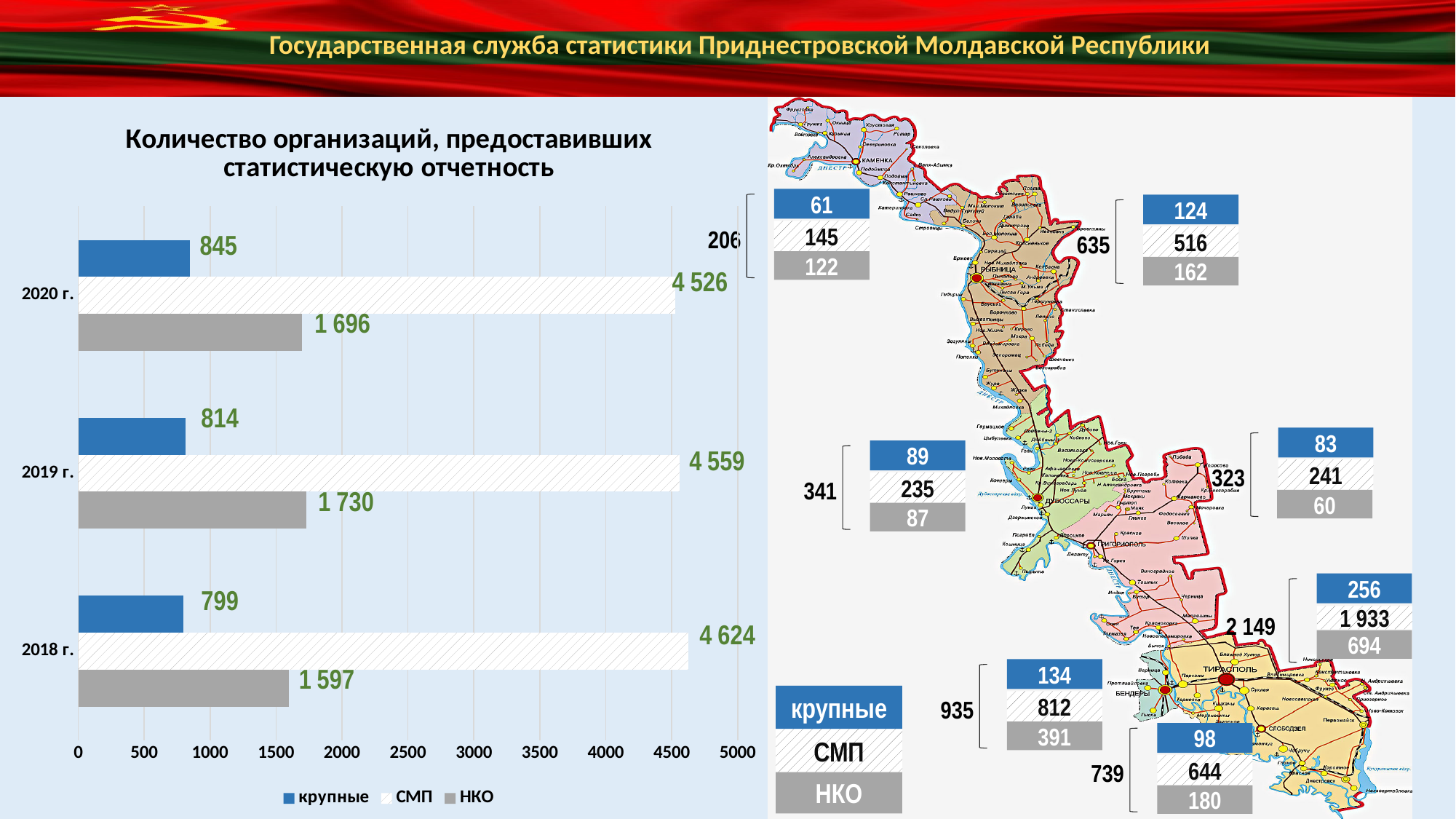
On the bar chart, which is larger: the НКО value for 2020 г. or for 2019 г.? 2019 г. On the bar chart, what is the difference between the СМП values for 2018 г. and 2020 г.? 98 On the bar chart, which year has the highest value for крупные? 2020 г. On the bar chart, what is the value for СМП in 2020 г.? 4 526 On the bar chart, what is the value for НКО in 2019 г.? 1 730 What type of chart is shown on the left of the slide? bar chart How many series does the bar chart's legend list? 3 On the bar chart, what is the value for крупные in 2018 г.? 799 On the bar chart, is the value for СМП in 2019 г. greater or less than 4500? greater What is the title of the bar chart? Количество организаций, предоставивших статистическую отчетность How many years are shown on the bar chart? 3 On the bar chart, which year has the lowest value for НКО? 2018 г.